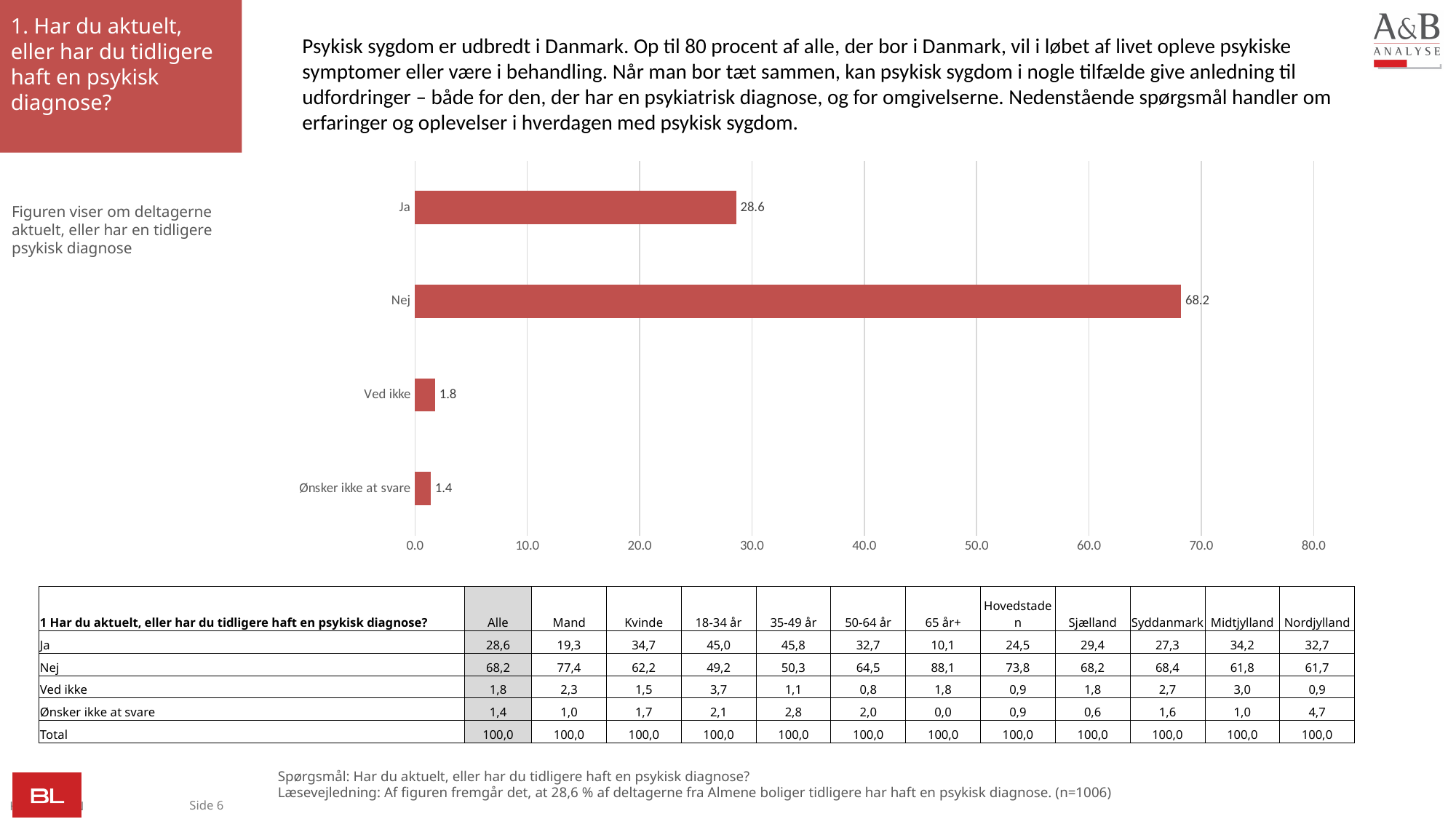
What is the value for "Ved ikke" in the bar chart? 1.8 What is the highest value shown on the x axis of the bar chart? 80.0 What is the value for "Nej" in the bar chart? 68.2 What is the value for "Ønsker ikke at svare" in the bar chart? 1.4 Is the value for "Ja" in the bar chart greater or less than 30.0? less Which category has the lowest value in the bar chart? Ønsker ikke at svare Which is larger in the bar chart, the value for "Ja" or the value for "Nej"? Nej How many categories are shown in the bar chart? 4 What is the value for "Ja" in the bar chart? 28.6 Which category has the highest value in the bar chart? Nej What kind of chart is shown on the slide? bar chart What is the difference between the values for "Nej" and "Ja" in the bar chart? 39.6